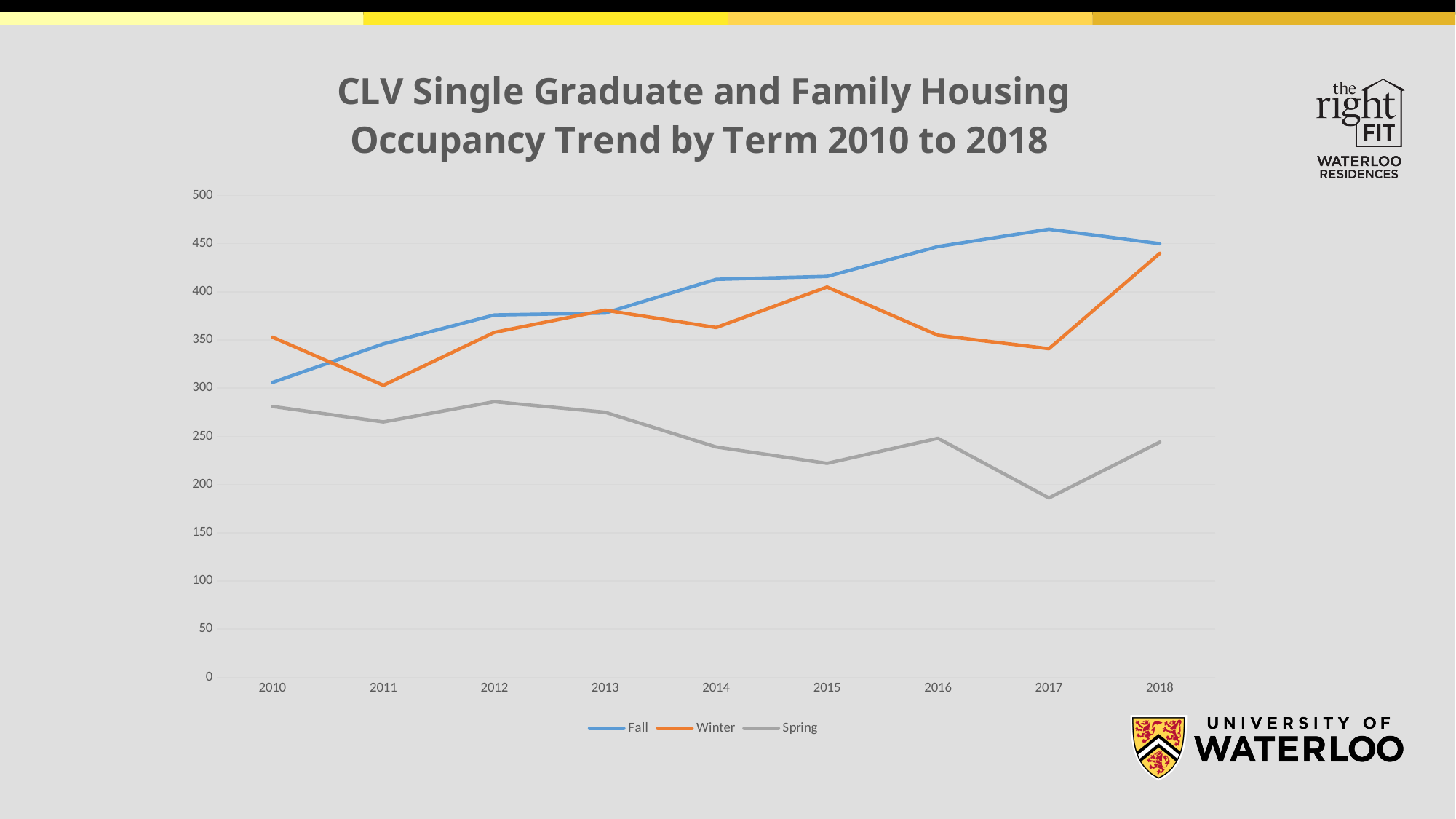
In which year does the Winter series reach its lowest value? 2011 Is the value for Fall in 2017 greater or less than 450? greater In which year does the Spring series reach its lowest value? 2017 How many years are plotted along the x axis? 9 Is the value for Spring in 2015 greater or less than 250? less What kind of chart is shown on the slide? line chart In which year does the Winter series reach its highest value? 2018 Does the Spring series generally rise or fall from 2010 to 2018? fall Is the value for Spring in 2017 greater or less than 200? less In 2010, which series has the higher value, Fall or Winter? Winter In which year does the Fall series reach its highest value? 2017 How many series does the legend list? 3